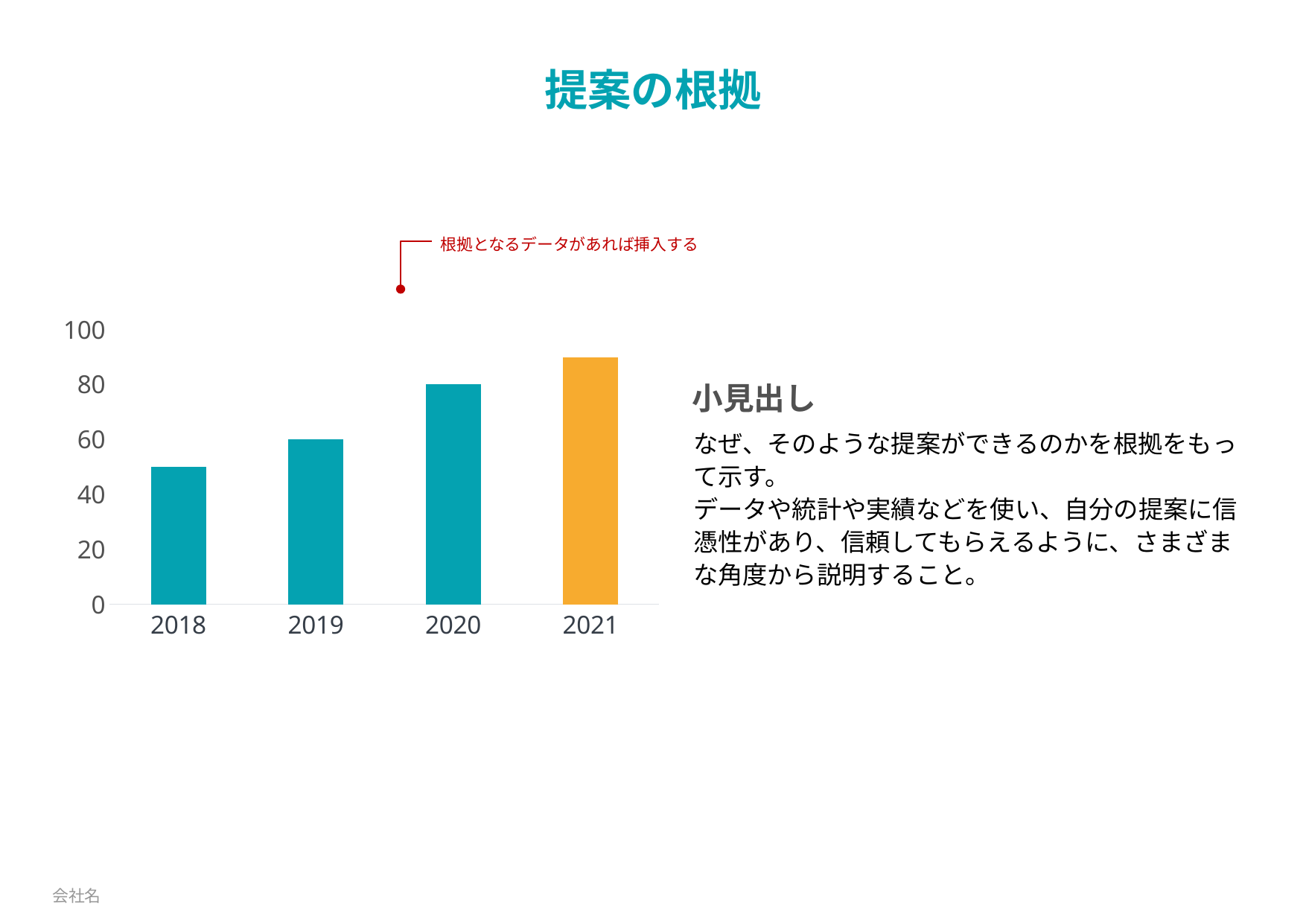
What is the value for 2019 in the chart? 60 Which year has the lowest bar in the chart? 2018 Is the value for 2018 greater or less than 60? less Which year's bar is coloured orange instead of teal? 2021 Is the value for 2021 greater or less than 80? greater What is the value for 2020 in the chart? 80 How many years are shown on the x axis of the chart? 4 Do the values rise or fall from 2018 to 2021? rise What kind of chart is shown on the slide? bar chart Which year has the highest bar in the chart? 2021 Is the value for 2018 greater or less than 40? greater Which is larger, the value for 2019 or the value for 2020? 2020